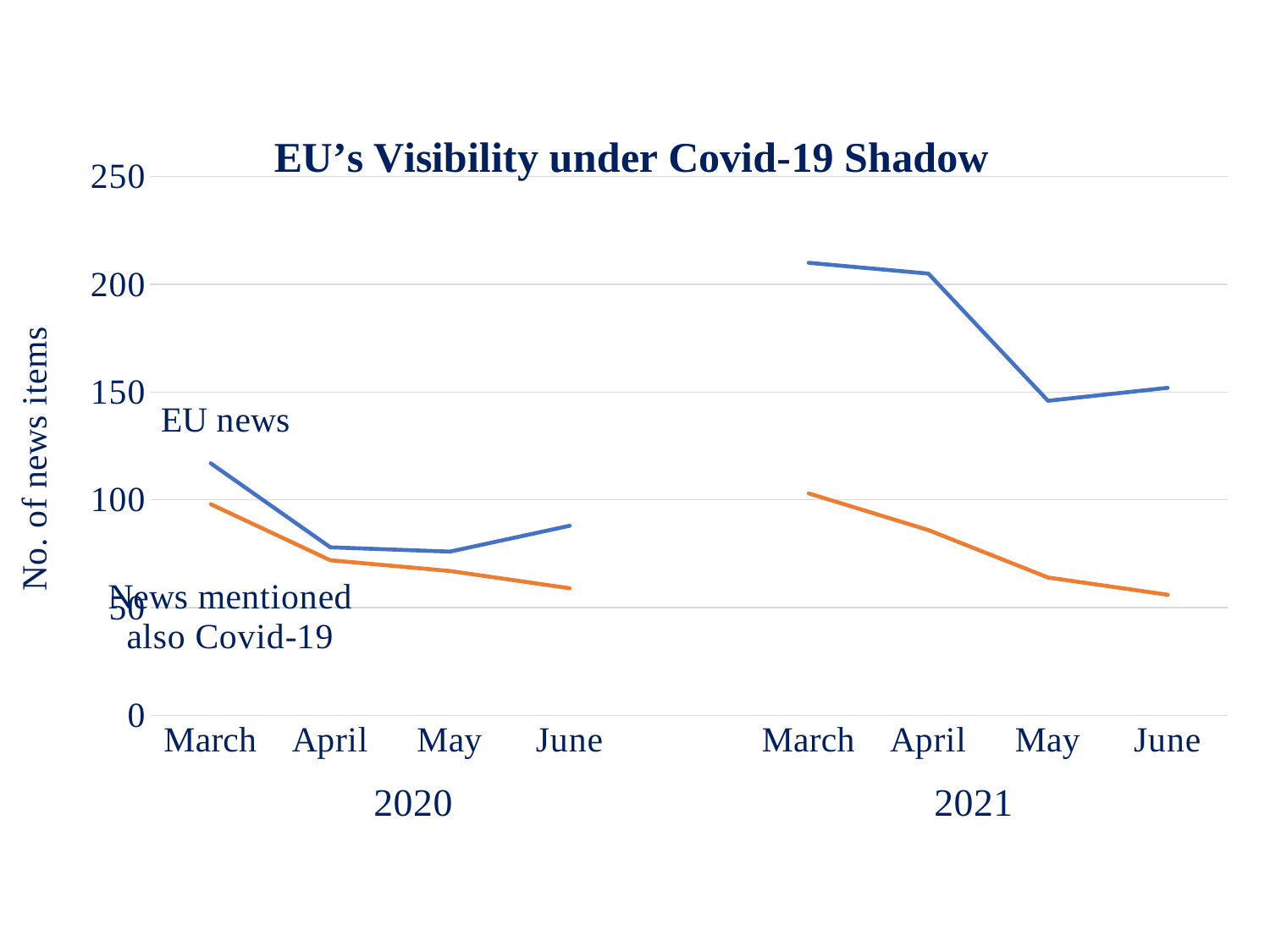
In which month and year does the EU news line reach its highest value? March 2021 What kind of chart is shown on the slide? line chart Is the value for EU news in April 2020 greater or less than 100? less How many lines (series) are plotted on the chart? 2 Is the value for EU news in March 2021 greater or less than 200? greater How many month labels are shown along the x axis of the chart? 8 Is the value for News mentioned also Covid-19 in June 2021 greater or less than 100? less What is the label on the vertical axis of the chart? No. of news items What is the title of the chart? EU's Visibility under Covid-19 Shadow Does the EU news line rise or fall from March 2021 to May 2021? fall Which is larger: EU news in March 2021 or EU news in March 2020? EU news in March 2021